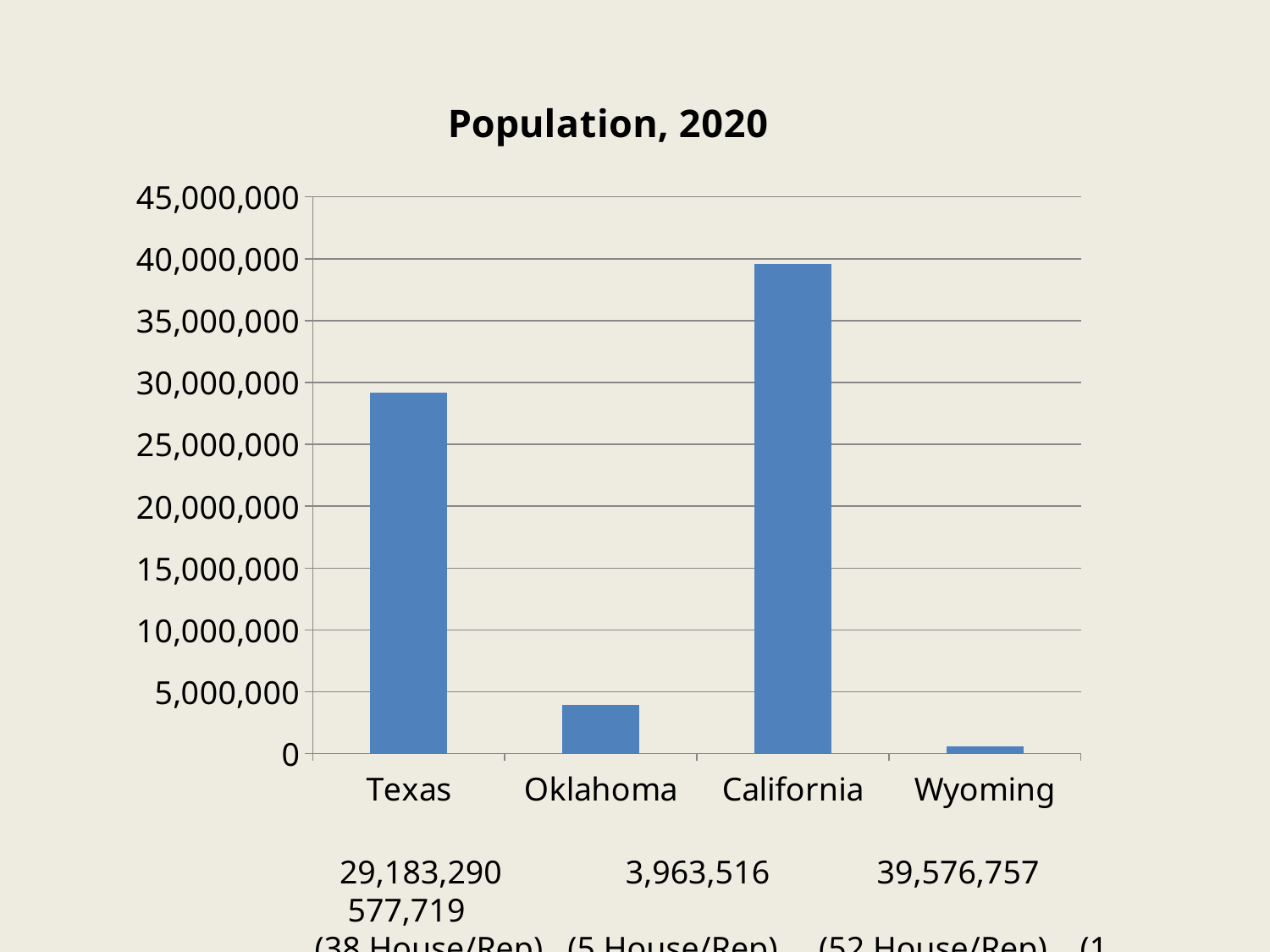
How many states are shown in the chart? 4 Which is larger, the population of Texas or Oklahoma? Texas What is the title of the chart? Population, 2020 Is the value for California greater or less than 35,000,000? greater What is the population shown for California? 39,576,757 What is the population shown for Texas? 29,183,290 What kind of chart is shown on the slide? bar chart What is the difference between the populations of California and Texas? 10,393,467 Which state has the lowest population in the chart? Wyoming What is the population shown for Oklahoma? 3,963,516 Which state has the highest population in the chart? California Is the value for Wyoming greater or less than 5,000,000? less